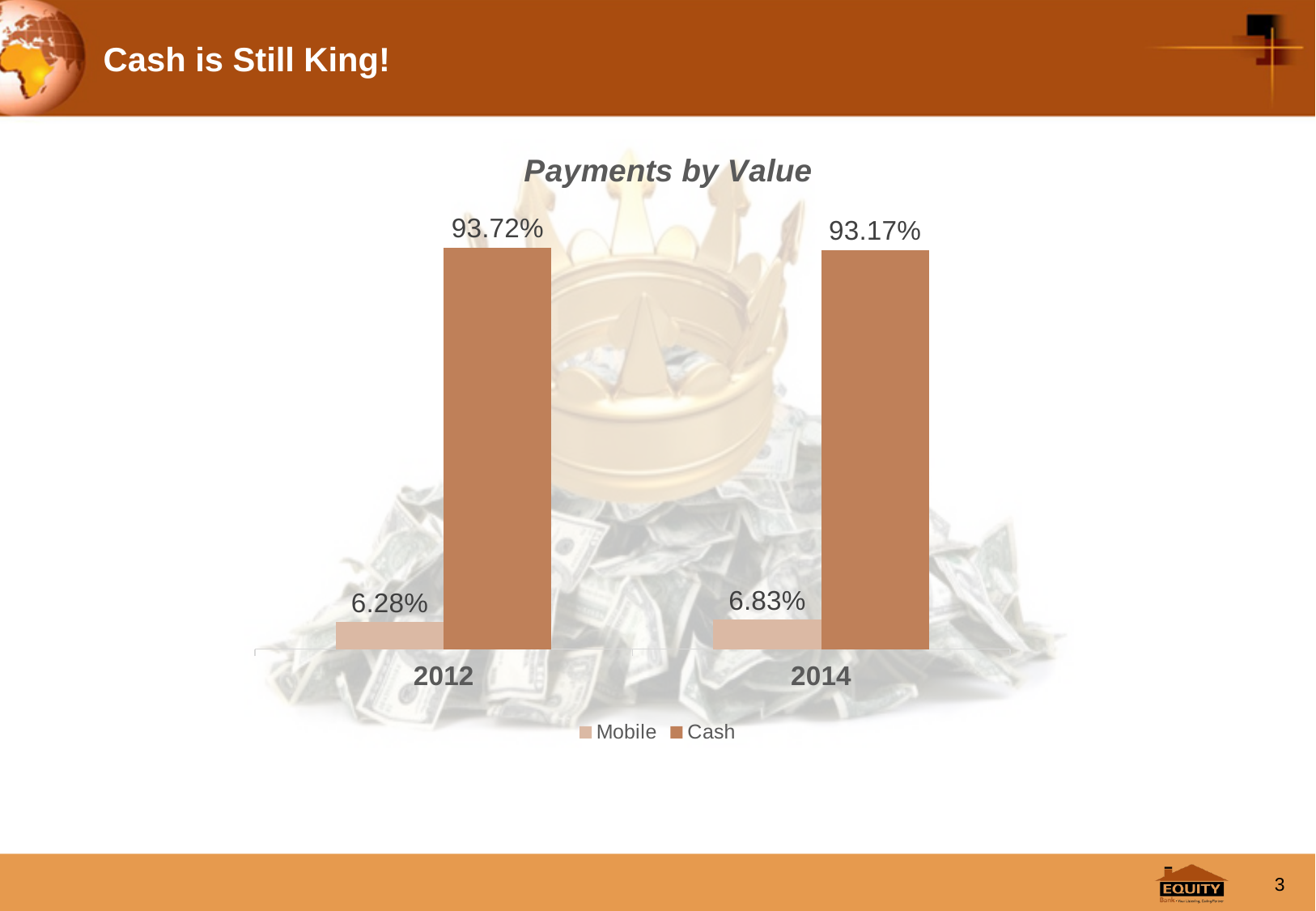
What is the value for Mobile in 2012? 6.28% In which year is the Cash value higher, 2012 or 2014? 2012 What is the value for Cash in 2012? 93.72% How many years are shown on the x axis? 2 Which series has the higher value in 2014, Mobile or Cash? Cash What is the value for Mobile in 2014? 6.83% What is the title of the chart? Payments by Value What kind of chart is shown? Bar chart How many series does the legend list? 2 What is the difference between the Cash values in 2012 and 2014? 0.55% What is the difference between the Mobile values in 2014 and 2012? 0.55% What is the value for Cash in 2014? 93.17%